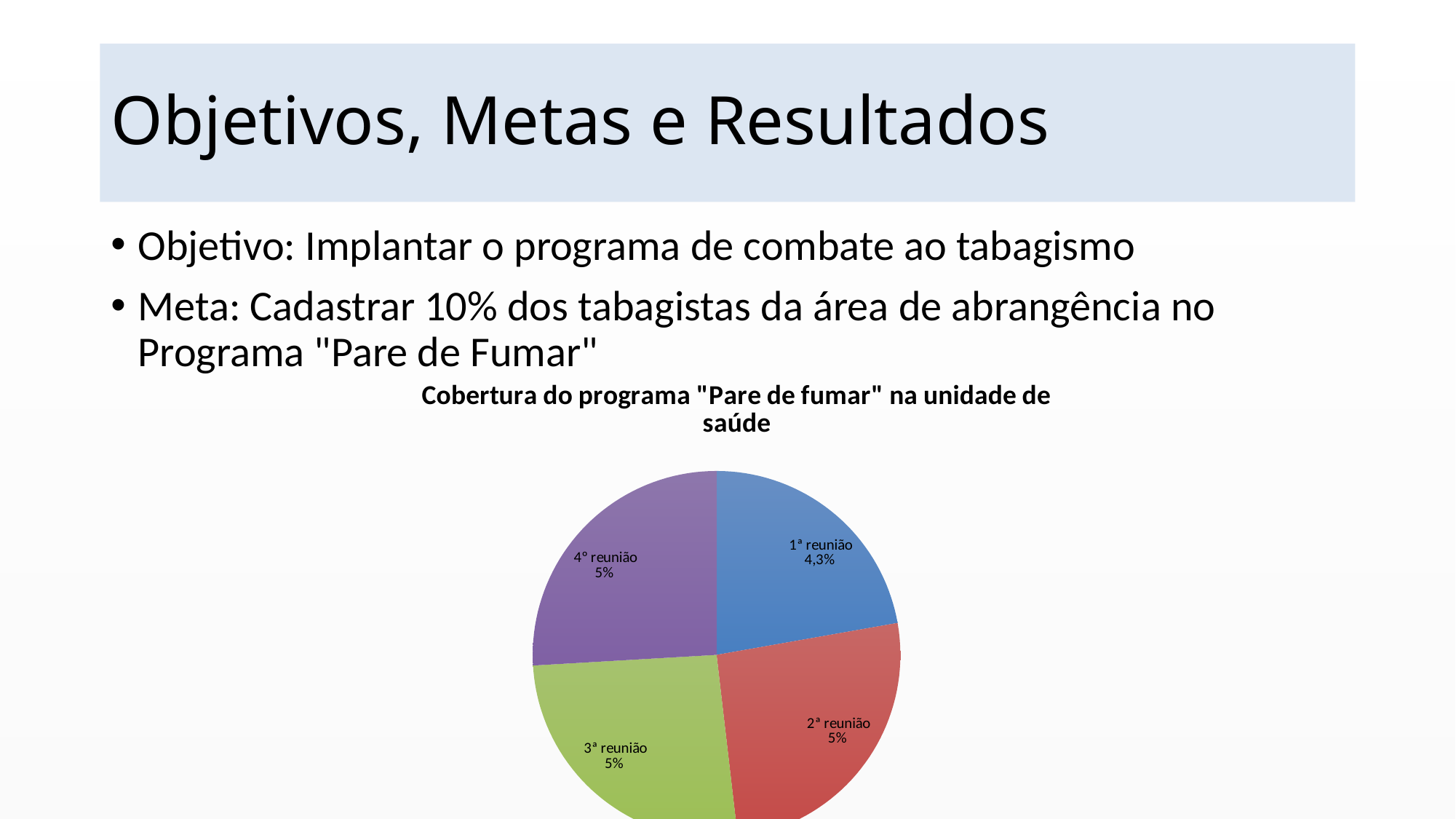
What value is shown for 4° reunião? 5% What colour is the slice for 1ª reunião? blue Which has the larger value, 1ª reunião or 3ª reunião? 3ª reunião What value is shown for 1ª reunião? 4,3% What value is shown for 2ª reunião? 5% What value is shown for 3ª reunião? 5% What is the title of the chart? Cobertura do programa "Pare de fumar" na unidade de saúde What kind of chart is shown on the slide? pie chart What is the difference between the values for 2ª reunião and 1ª reunião? 0,7% How many slices does the pie chart have? 4 Which slice has the lowest value? 1ª reunião